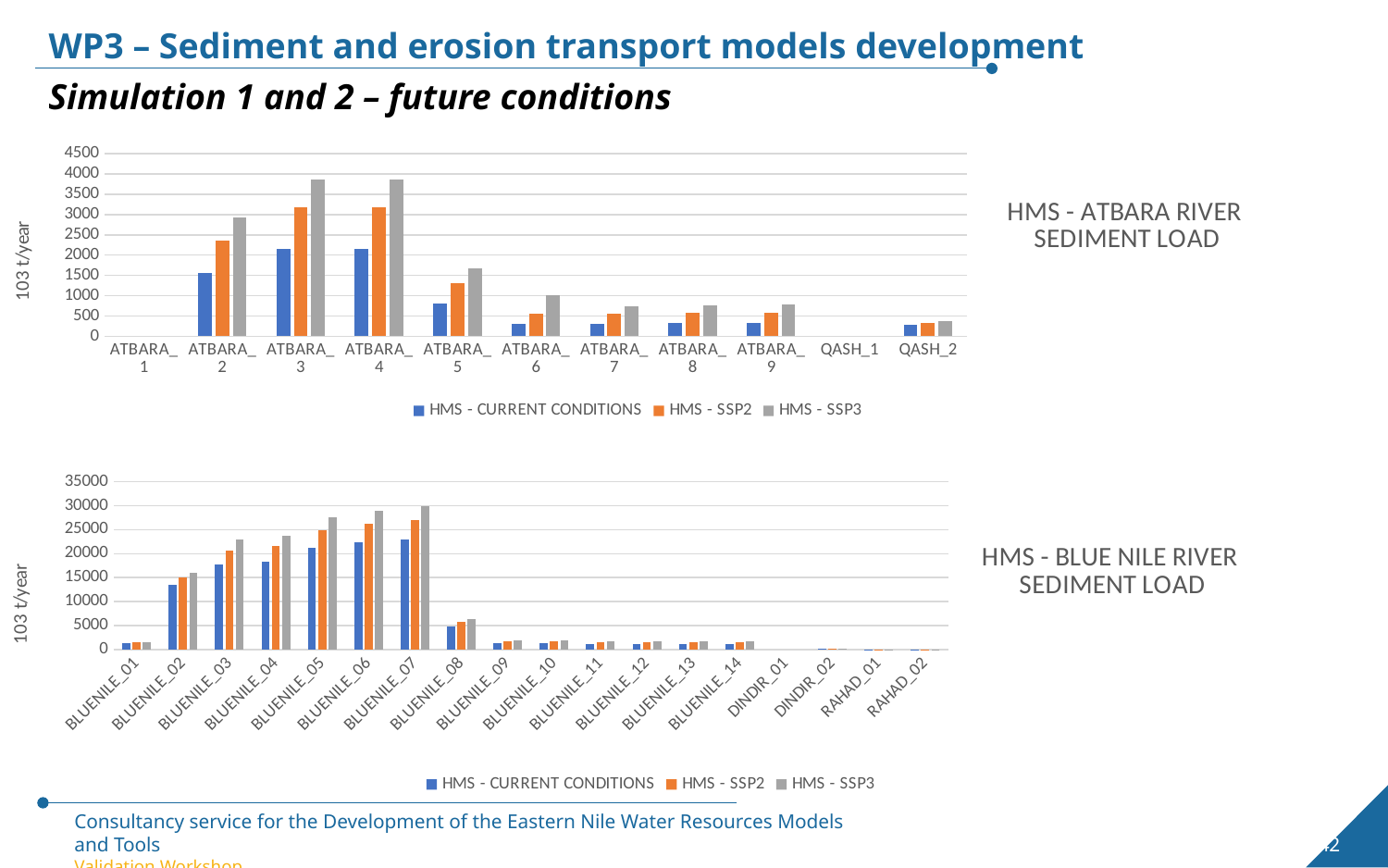
On the HMS - ATBARA RIVER SEDIMENT LOAD chart, how many series does the legend list? 3 On the HMS - ATBARA RIVER SEDIMENT LOAD chart, is the HMS - SSP3 value for ATBARA_2 greater or less than 2500? greater On the HMS - BLUE NILE RIVER SEDIMENT LOAD chart, is the HMS - CURRENT CONDITIONS value for BLUENILE_06 greater or less than 20000? greater On the HMS - BLUE NILE RIVER SEDIMENT LOAD chart, how many categories are shown on the x axis? 18 What kind of chart is the HMS - BLUE NILE RIVER SEDIMENT LOAD chart? Bar chart On the HMS - ATBARA RIVER SEDIMENT LOAD chart, is the HMS - CURRENT CONDITIONS value for ATBARA_5 greater or less than 1000? less On the HMS - ATBARA RIVER SEDIMENT LOAD chart, how many categories are shown on the x axis? 11 What is the y-axis label on the HMS - ATBARA RIVER SEDIMENT LOAD chart? 103 t/year On the HMS - ATBARA RIVER SEDIMENT LOAD chart, which is larger, the HMS - SSP3 value for ATBARA_2 or for ATBARA_5? ATBARA_2 On the HMS - BLUE NILE RIVER SEDIMENT LOAD chart, which is larger, the HMS - CURRENT CONDITIONS value for BLUENILE_03 or for BLUENILE_08? BLUENILE_03